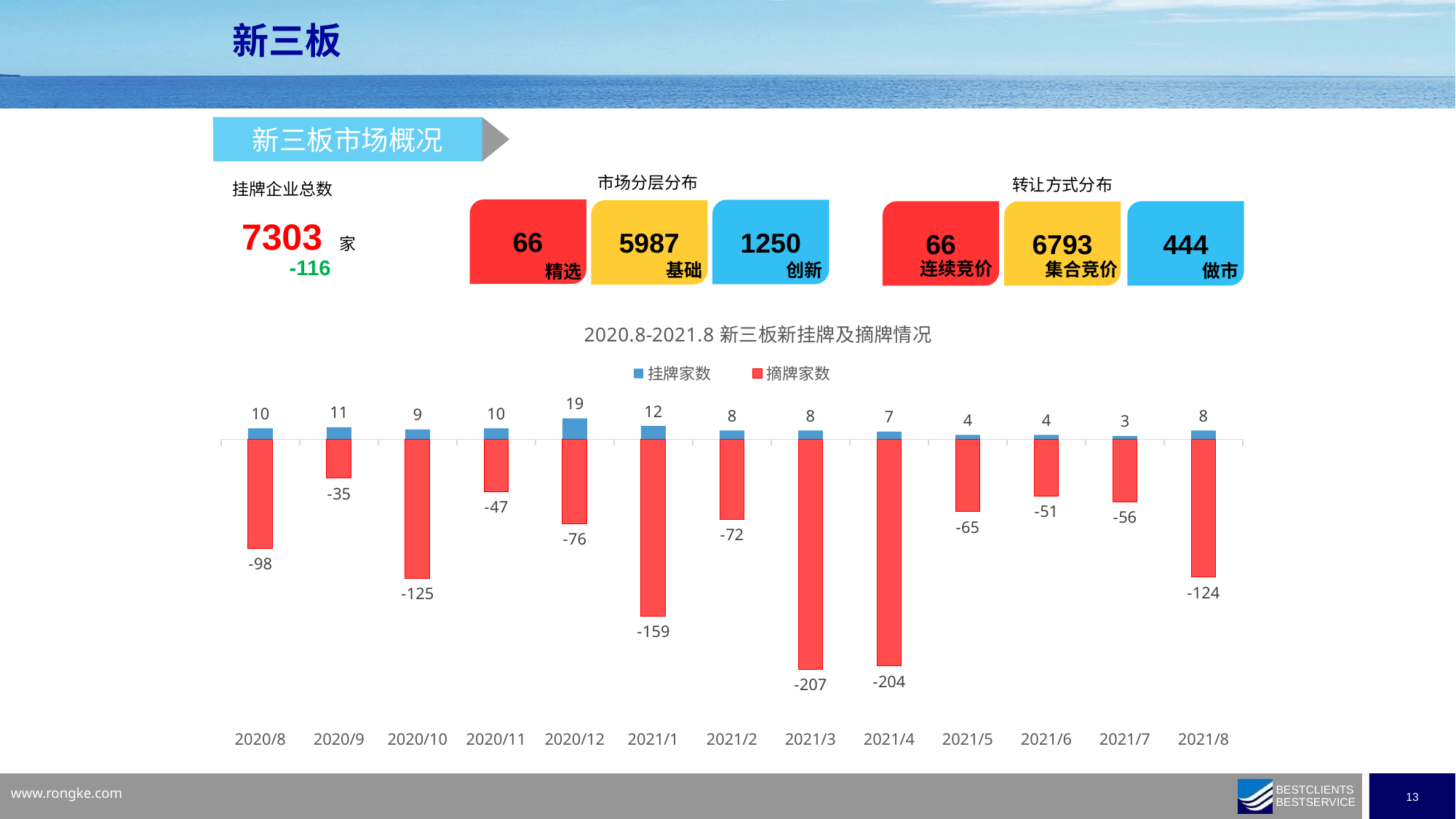
Which month has the lowest 挂牌家数? 2021/7 What is the value of 摘牌家数 for 2021/8? -124 Which month has the highest 挂牌家数? 2020/12 What is the difference between 挂牌家数 for 2020/12 and 2021/1? 7 How many months are shown on the x axis of the chart? 13 What type of chart is shown on the slide? bar chart What is the value of 摘牌家数 for 2021/3? -207 Is the 摘牌家数 bar for 2021/3 or 2021/5 longer? 2021/3 What is the title of the chart? 2020.8-2021.8 新三板新挂牌及摘牌情况 What is the value of 挂牌家数 for 2020/12? 19 Which month has the smallest 摘牌家数 in absolute terms (the shortest red bar)? 2020/9 How many series does the legend list in the chart? 2